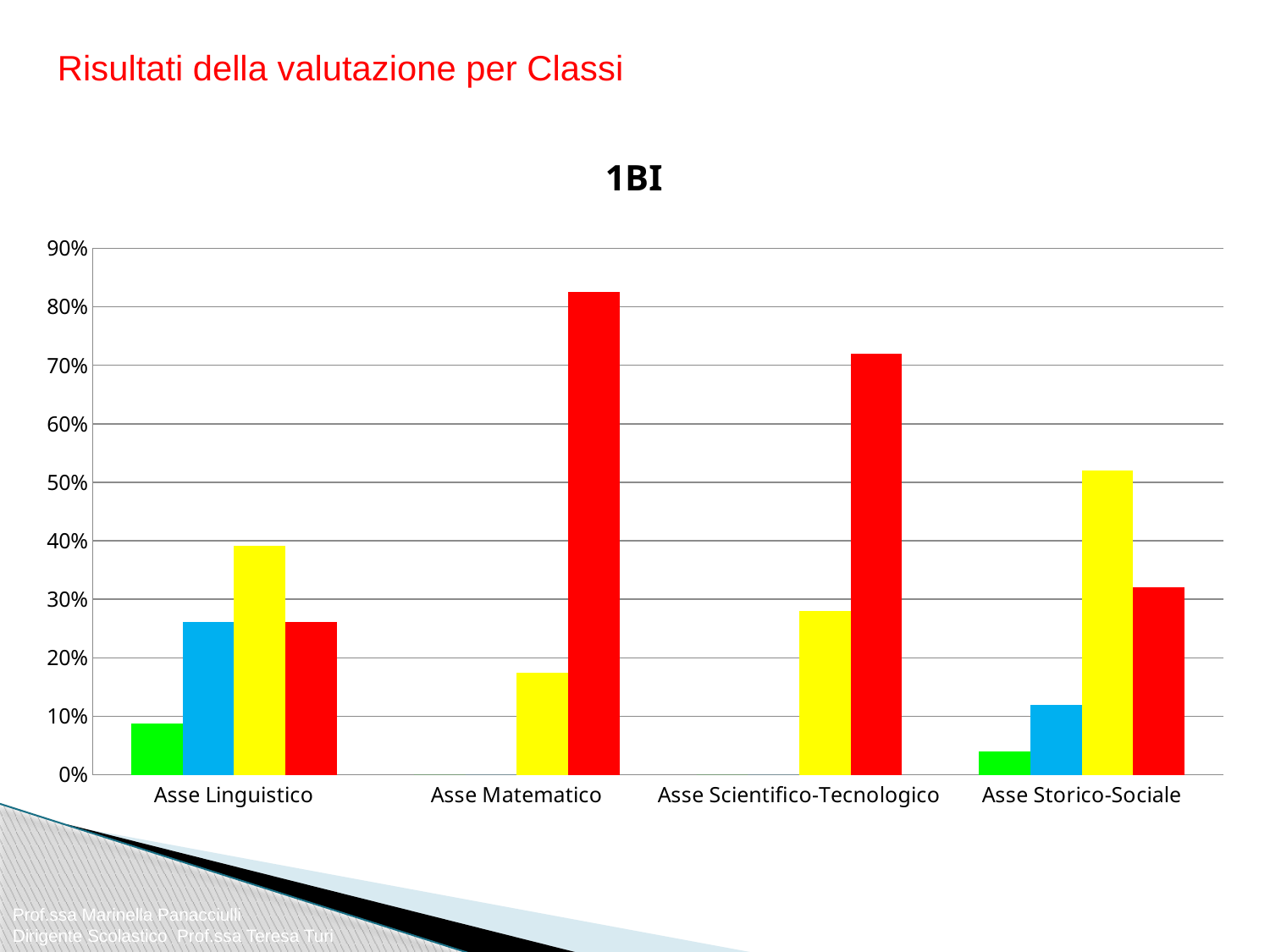
What type of chart is shown on the slide? bar chart Which is larger: the yellow bar for Asse Linguistico or the yellow bar for Asse Storico-Sociale? Asse Storico-Sociale Is the value of the yellow bar for Asse Matematico greater or less than 20%? less Is the value of the red bar for Asse Matematico greater or less than 70%? greater How many categories are shown on the x axis of the chart? 4 What is the title of the chart? 1BI Is the value of the green bar for Asse Linguistico greater or less than 10%? less What colour is the tallest bar in the chart? red Which category contains the tallest bar in the chart? Asse Matematico Which is larger: the red bar for Asse Matematico or the red bar for Asse Scientifico-Tecnologico? Asse Matematico